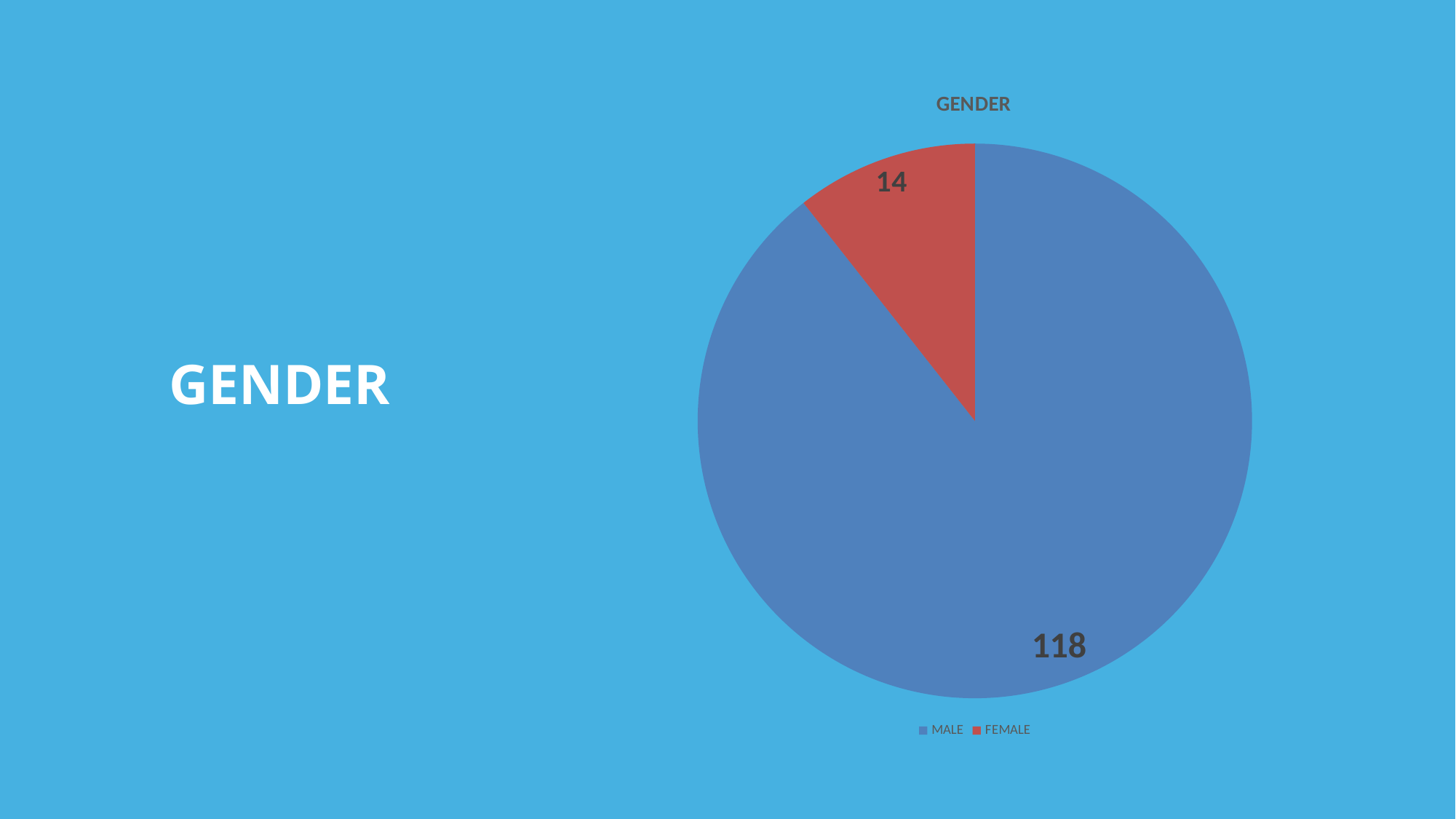
What is the total of all slices in the pie chart? 132 What is the title of the chart? GENDER How many categories does the pie chart show? 2 What is the difference between the MALE and FEMALE values? 104 What is the value for MALE in the pie chart? 118 What kind of chart is shown on the slide? Pie chart What is the value for FEMALE in the pie chart? 14 Which category has the smallest slice in the pie chart? FEMALE What colour is the FEMALE slice in the pie chart? Red Which is larger, the value for MALE or the value for FEMALE? MALE Which category has the largest slice in the pie chart? MALE